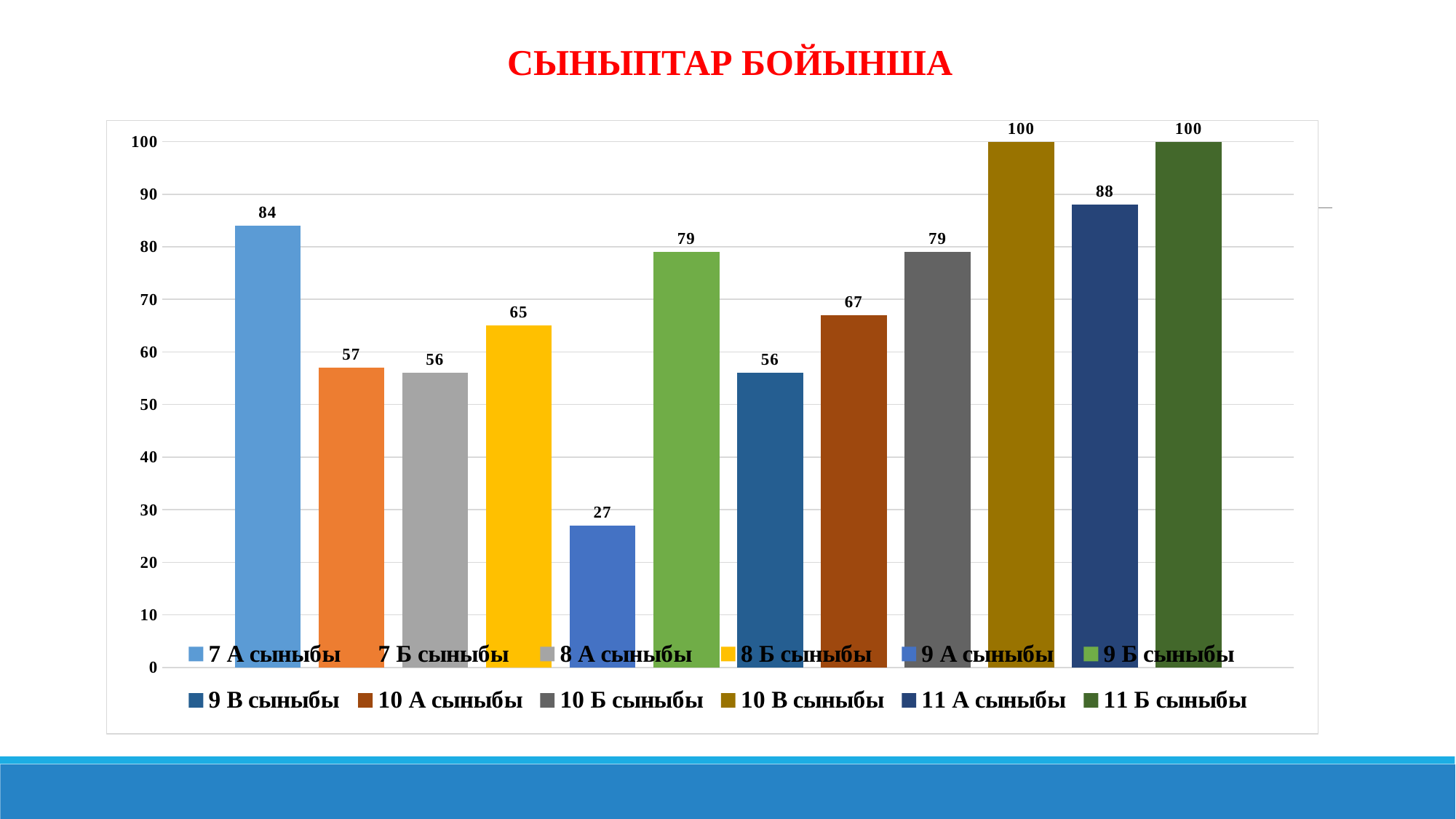
Which is larger, the value for 8 Б сыныбы or the value for 7 Б сыныбы? 8 Б сыныбы What is the value for 7 А сыныбы? 84 Which class has the lowest value? 9 А сыныбы What is the difference between the values for 11 А сыныбы and 7 А сыныбы? 4 What is the value for 10 А сыныбы? 67 What is the title of the slide? СЫНЫПТАР БОЙЫНША What is the value for 11 А сыныбы? 88 What is the difference between the values for 10 В сыныбы and 9 А сыныбы? 73 What kind of chart is shown on the slide? Bar chart How many series does the legend list? 12 What is the value for 9 А сыныбы? 27 What is the highest value shown on the chart? 100